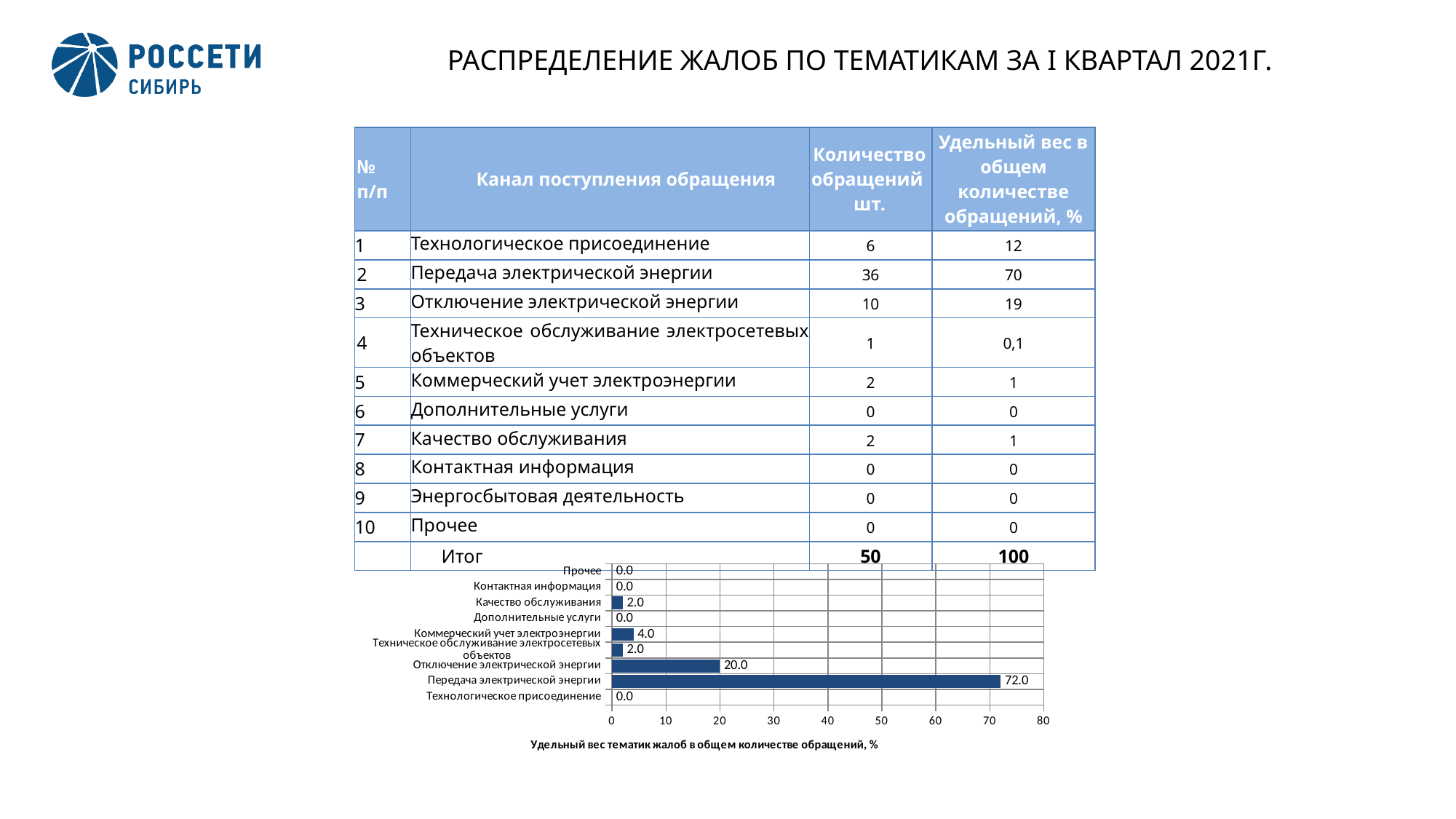
In the bar chart, what is the value for Передача электрической энергии? 72.0 In the bar chart, what is the value for Качество обслуживания? 2.0 In the bar chart, which is larger: the value for Коммерческий учет электроэнергии or the value for Качество обслуживания? Коммерческий учет электроэнергии In the bar chart, is the value for Передача электрической энергии greater or less than 70? greater What kind of chart is shown on the slide? bar chart In the bar chart, what is the value for Коммерческий учет электроэнергии? 4.0 How many categories are shown in the bar chart? 9 In the bar chart, what is the value for Технологическое присоединение? 0.0 What is the title of the bar chart? Удельный вес тематик жалоб в общем количестве обращений, % In the bar chart, what is the value for Отключение электрической энергии? 20.0 In the bar chart, what is the difference between the values for Передача электрической энергии and Отключение электрической энергии? 52.0 In the bar chart, which category has the highest value? Передача электрической энергии